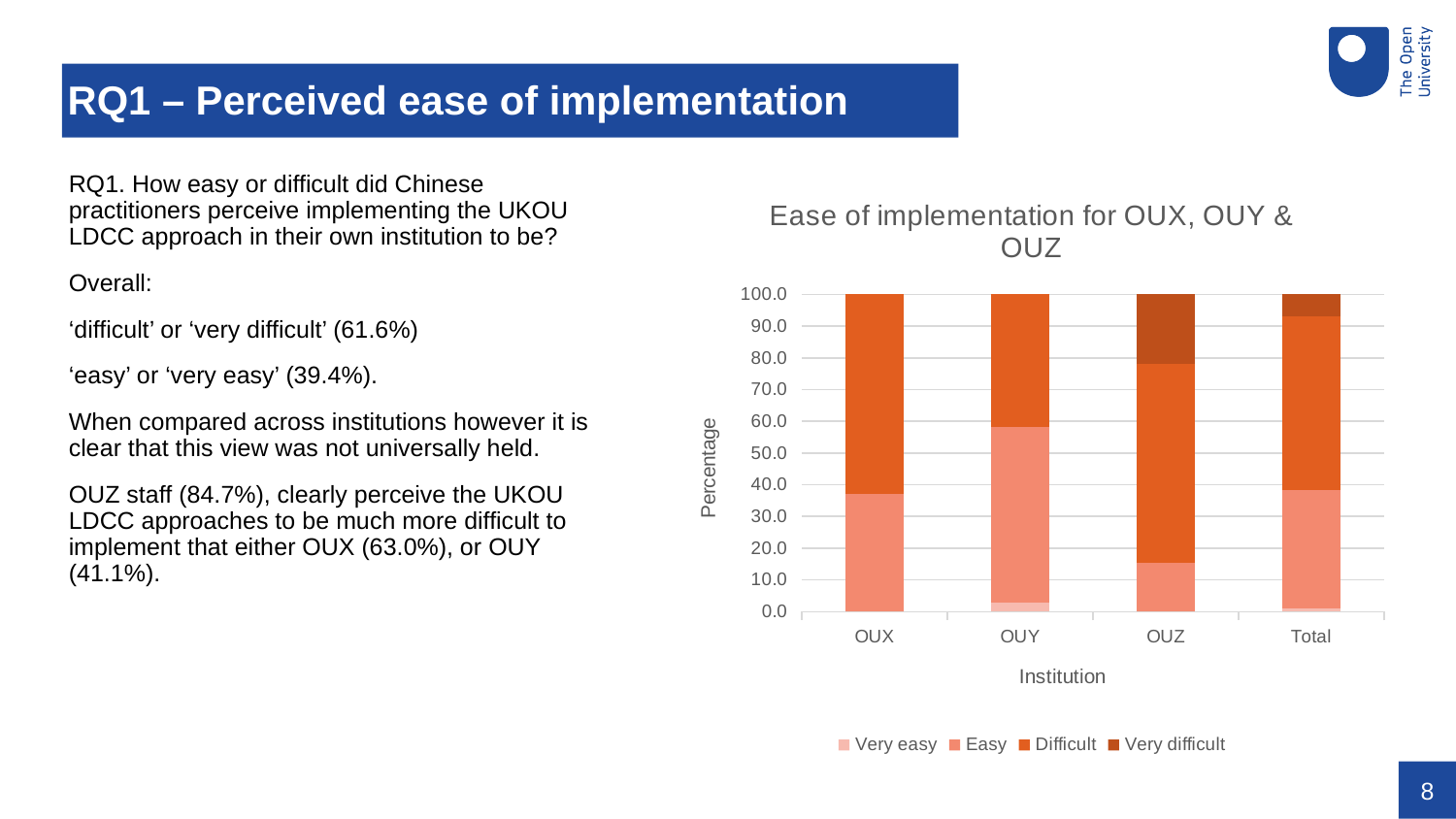
Is the top of the 'Easy' segment for OUY greater or less than 50.0 on the percentage axis? greater Which institution has the smallest 'Easy' segment in the chart? OUZ How many institutions (categories) are shown on the x axis of the chart? 4 Is the top of the 'Easy' segment for OUZ greater or less than 20.0 on the percentage axis? less Which institution has the largest 'Very difficult' segment in the chart? OUZ What is the title of the chart? Ease of implementation for OUX, OUY & OUZ What is the label of the y axis of the chart? Percentage Is the top of the 'Easy' segment for OUX greater or less than 30.0 on the percentage axis? greater Is the 'Easy' segment for OUY larger or smaller than the 'Easy' segment for OUZ? larger How many series does the chart legend list? 4 Which institution has the largest 'Easy' segment in the chart? OUY What kind of chart is shown on the slide? Stacked bar chart